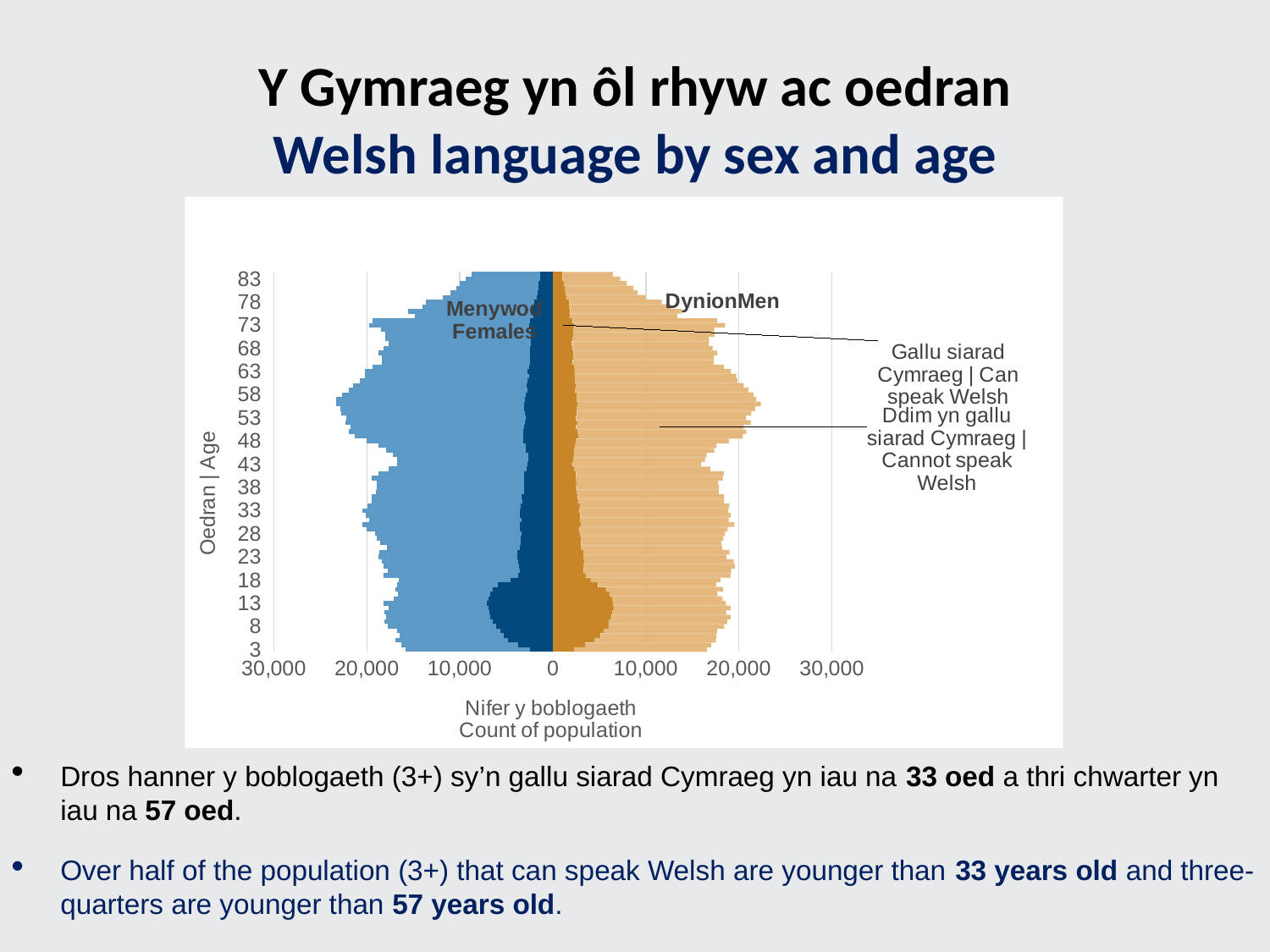
Is the total bar for Females (Menywod) at age 58 greater or less than 20,000? greater What is the English title of the chart on the slide? Welsh language by sex and age Is the total bar for Females (Menywod) at age 3 greater or less than 20,000? less Is the total bar for Men (Dynion) at age 13 greater or less than 10,000? greater Which side of the chart shows Men (Dynion), the left or the right? Right What is the label of the horizontal axis of the chart? Nifer y boblogaeth / Count of population How many age labels are shown on the vertical axis of the chart? 17 What kind of chart is shown on the slide? Bar chart